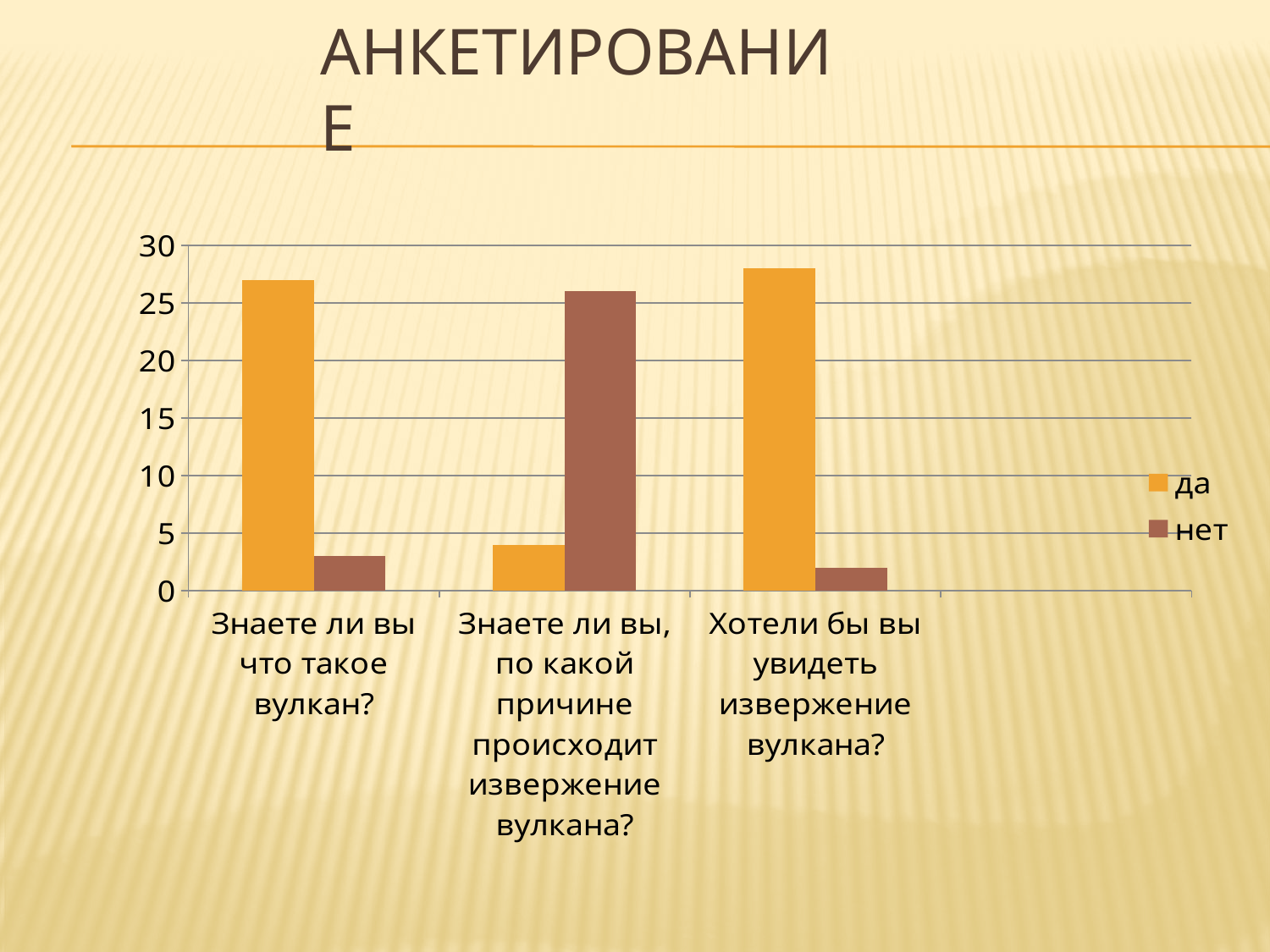
Is the value for "да" for "Знаете ли вы что такое вулкан?" greater or less than 25? greater Which question has the highest "да" value? Хотели бы вы увидеть извержение вулкана? Which question has the lowest "да" value? Знаете ли вы, по какой причине происходит извержение вулкана? How many question categories are shown on the x axis? 3 Is the value for "нет" for "Знаете ли вы, по какой причине происходит извержение вулкана?" greater or less than 25? greater What kind of chart is shown on the slide? bar chart For "Знаете ли вы, по какой причине происходит извержение вулкана?", which is larger, "да" or "нет"? нет Is the value for "нет" for "Знаете ли вы что такое вулкан?" greater or less than 5? less What are the two series named in the legend? да and нет How many series does the legend list? 2